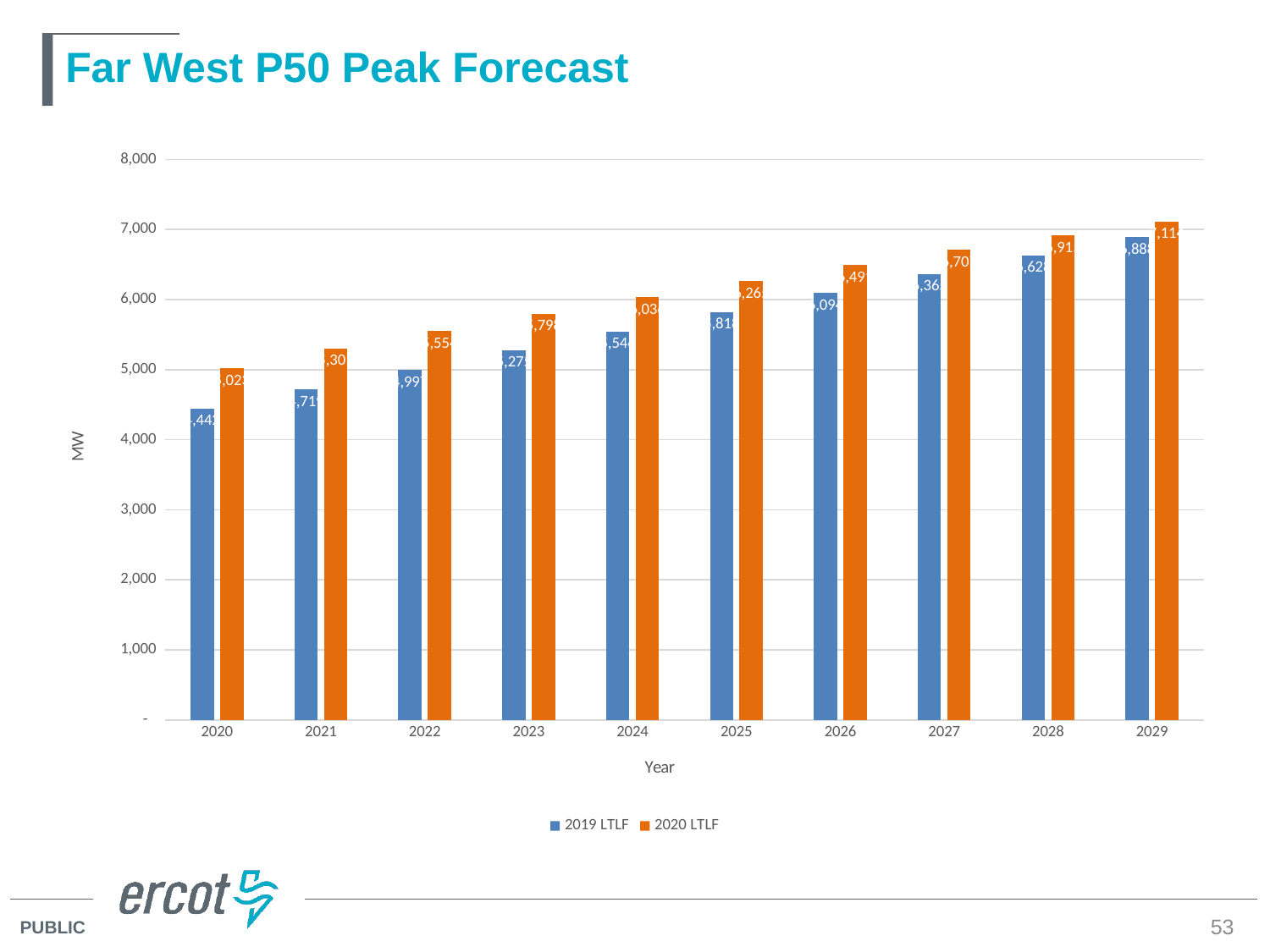
What kind of chart is shown on the slide? bar chart Which year has the highest 2020 LTLF value? 2029 How many years are shown on the x axis? 10 Is the 2019 LTLF value for 2029 greater or less than 7,000? less Is the 2019 LTLF value for 2020 greater or less than 4,000? greater What is the label on the vertical axis? MW Is the 2020 LTLF value for 2026 greater or less than 6,000? greater Which year has the lowest 2019 LTLF value? 2020 In 2027, which series has the larger value, 2019 LTLF or 2020 LTLF? 2020 LTLF Which colour represents the 2020 LTLF series? orange How many series does the legend list? 2 Do the 2020 LTLF values rise or fall from 2020 to 2029? rise